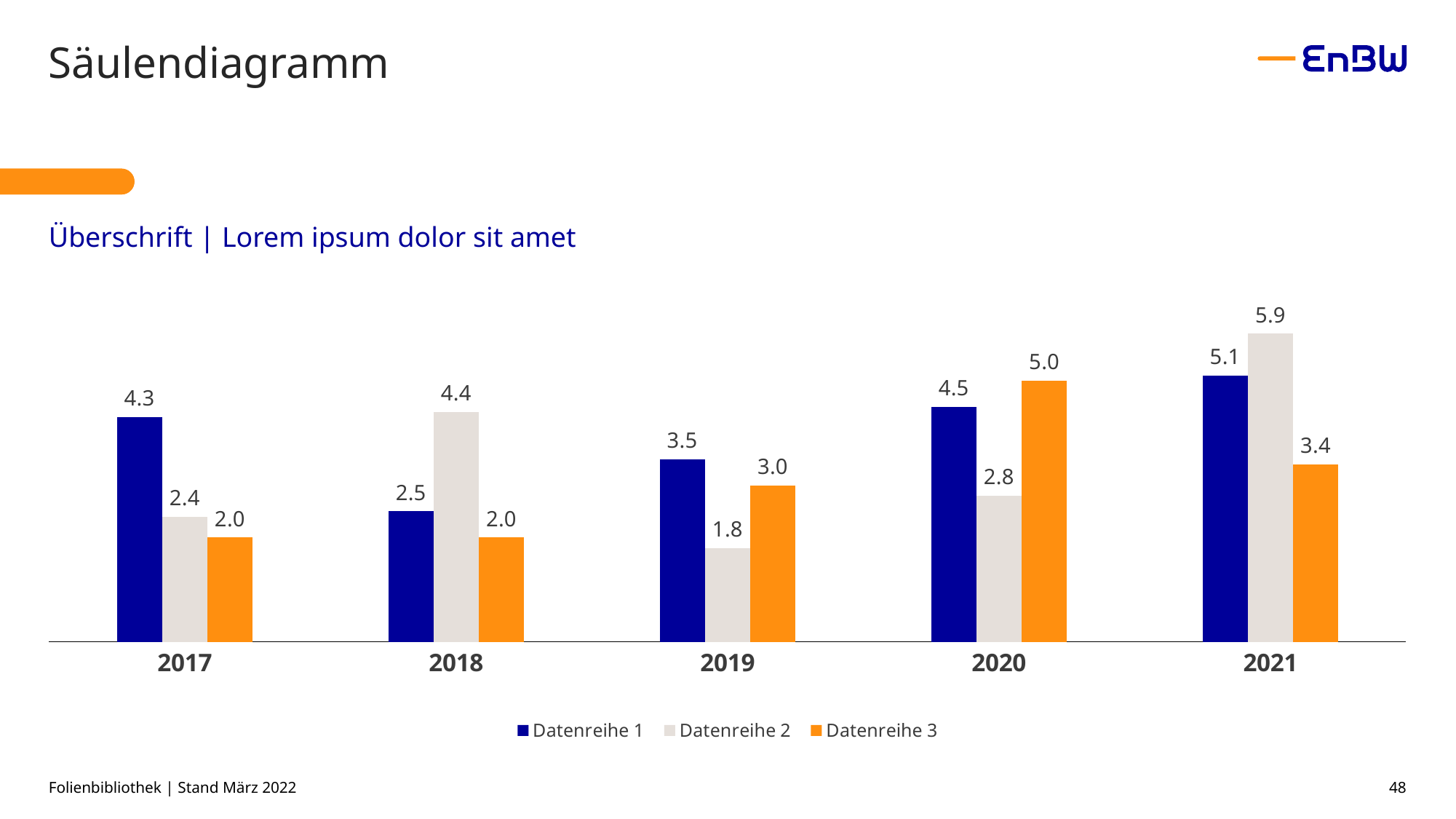
Which year has the highest value for Datenreihe 2? 2021 Which is larger in 2018: Datenreihe 1 or Datenreihe 2? Datenreihe 2 What is the value for Datenreihe 1 in 2017? 4.3 How many years are shown on the x axis? 5 What colour are the bars for Datenreihe 3? Orange What is the difference between Datenreihe 2 and Datenreihe 1 in 2021? 0.8 What is the value for Datenreihe 2 in 2019? 1.8 What is the value for Datenreihe 3 in 2020? 5.0 Which year has the lowest value for Datenreihe 1? 2018 What kind of chart is shown on the slide? Bar chart How many series does the legend list? 3 Does the value for Datenreihe 3 rise or fall from 2019 to 2020? Rise